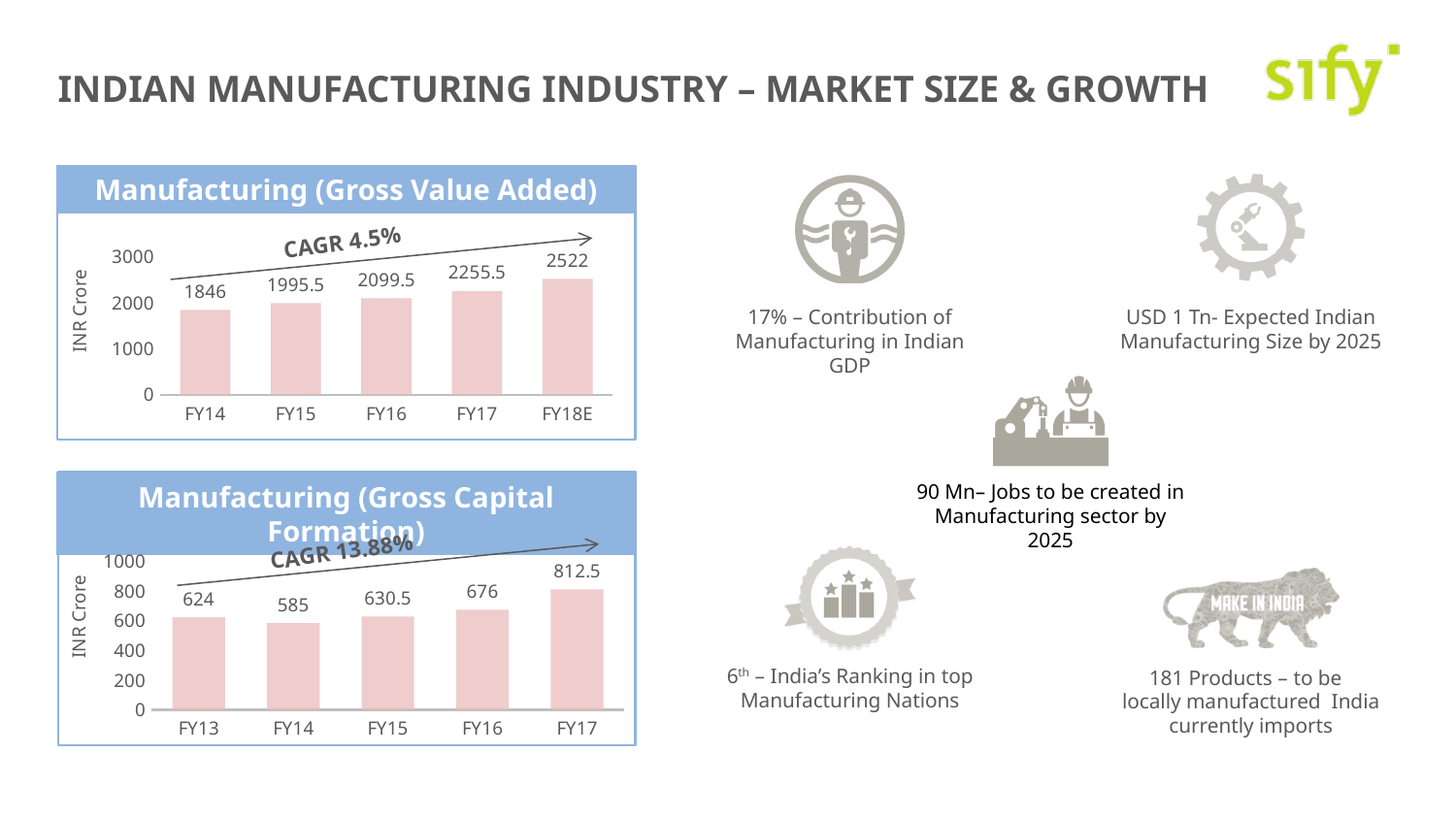
In the Manufacturing (Gross Capital Formation) chart, what is the value for FY14? 585 In the Manufacturing (Gross Capital Formation) chart, what is the difference between FY17 and FY16? 136.5 How many bars are in the Manufacturing (Gross Capital Formation) chart? 5 In the Manufacturing (Gross Value Added) chart, what is the value for FY18E? 2522 In the Manufacturing (Gross Value Added) chart, what CAGR is shown? CAGR 4.5% In the Manufacturing (Gross Value Added) chart, what is the value for FY16? 2099.5 In the Manufacturing (Gross Capital Formation) chart, which year has the highest value? FY17 In the Manufacturing (Gross Value Added) chart, do the values rise or fall from FY14 to FY18E? rise In the Manufacturing (Gross Value Added) chart, which year has the lowest value? FY14 In the Manufacturing (Gross Value Added) chart, what is the difference between FY17 and FY14? 409.5 In the Manufacturing (Gross Capital Formation) chart, which year has the lowest value? FY14 In the Manufacturing (Gross Capital Formation) chart, which is larger, FY13 or FY15? FY15